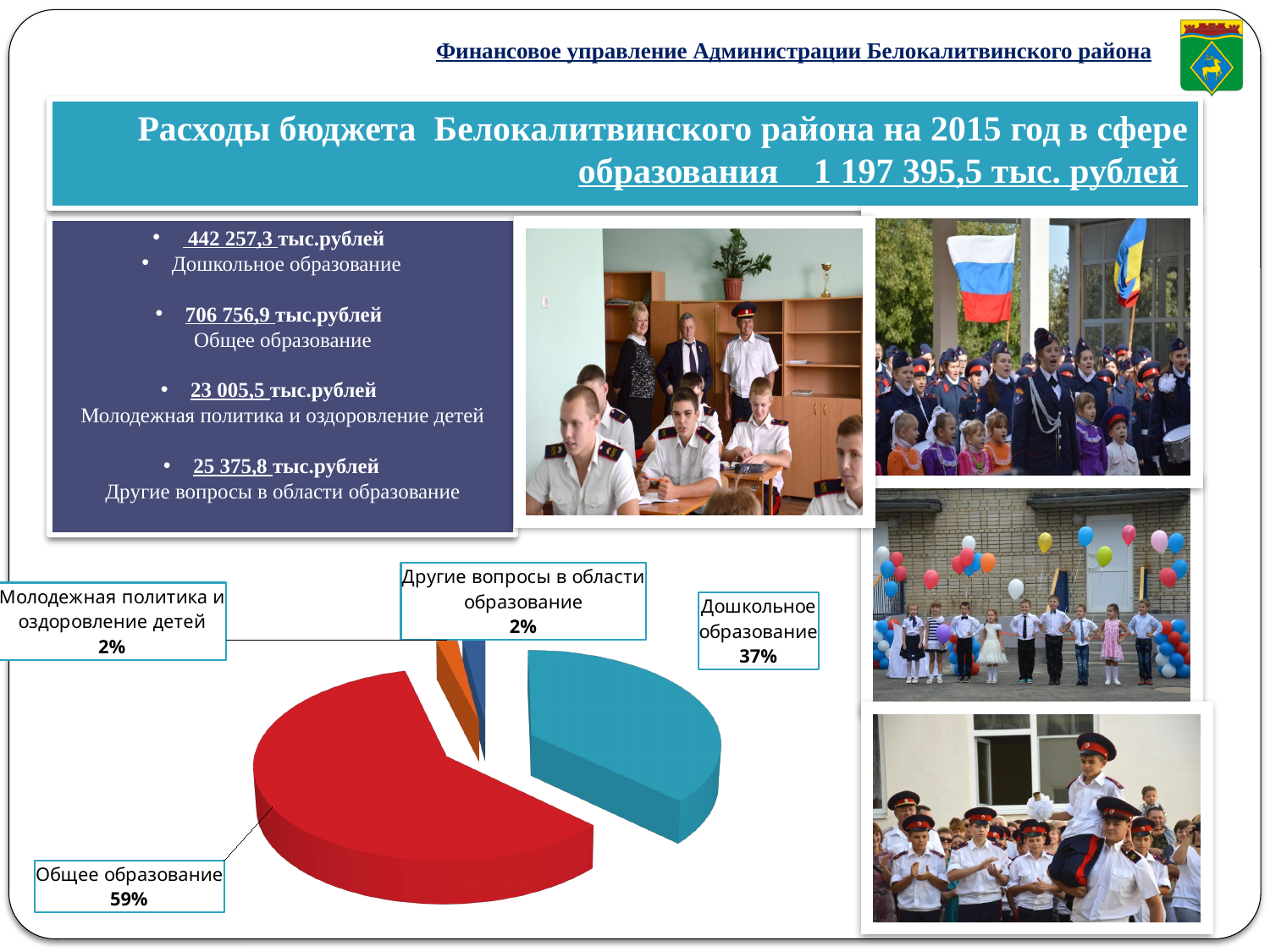
Which is larger, the share for Общее образование or the share for Дошкольное образование? Общее образование Which category has the largest slice of the pie? Общее образование What colour is the slice for Общее образование in the pie chart? red What share of the pie does Молодежная политика и оздоровление детей have? 2% How many slices does the pie chart have? 4 What kind of chart is shown on the slide? pie chart What share of the pie does Общее образование have? 59% What share of the pie does Другие вопросы в области образование have? 2% What colour is the slice for Дошкольное образование in the pie chart? blue What is the difference in percentage points between the shares of Общее образование and Дошкольное образование? 22 What is the difference in percentage points between the shares of Дошкольное образование and Молодежная политика и оздоровление детей? 35